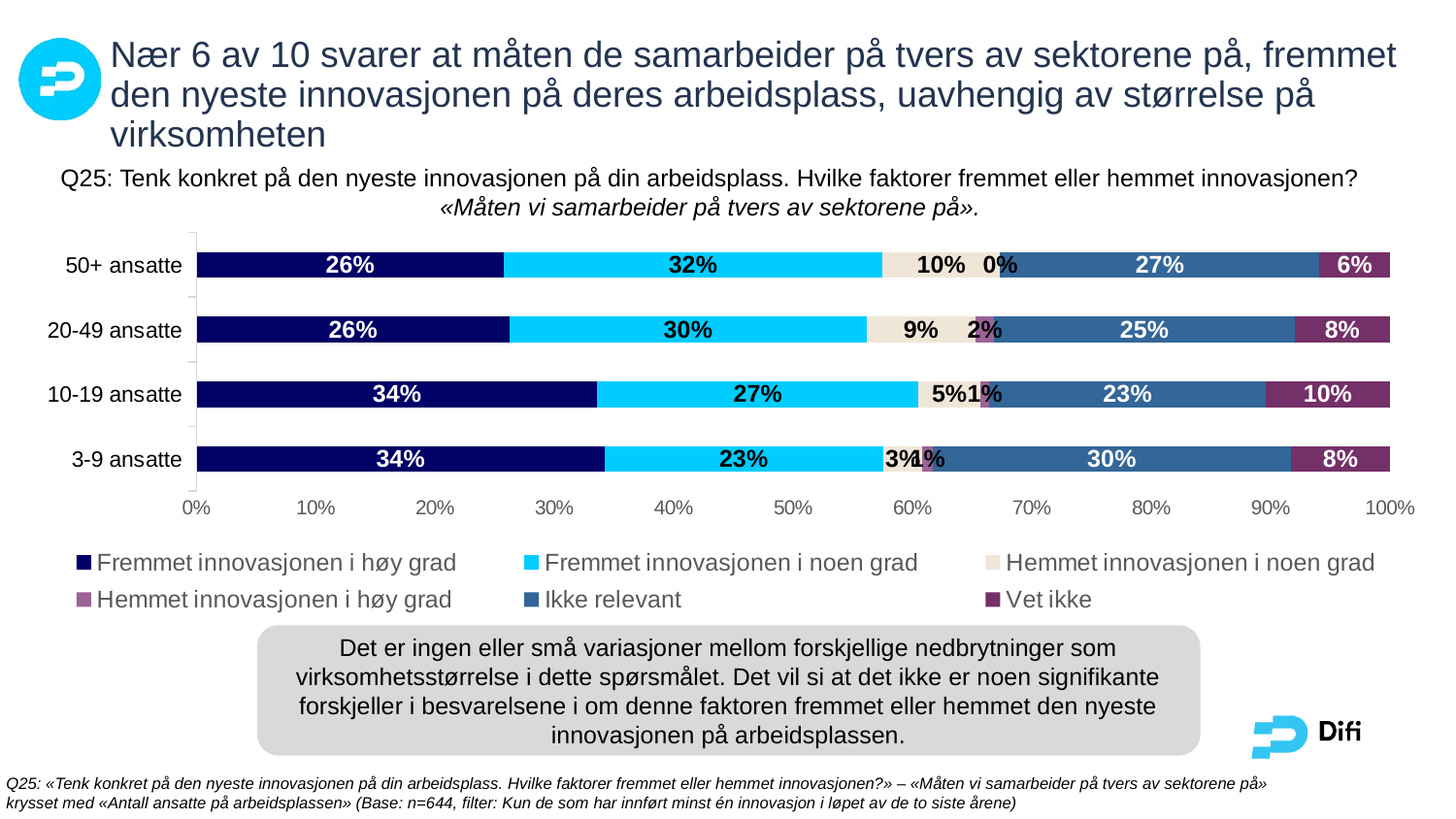
What is the value of "Fremmet innovasjonen i noen grad" for 50+ ansatte? 32% Which category has the highest value for "Fremmet innovasjonen i noen grad"? 50+ ansatte What kind of chart is shown on the slide? Stacked bar chart What is the difference between the "Fremmet innovasjonen i noen grad" values for 50+ ansatte and 3-9 ansatte? 9% What is the value of "Fremmet innovasjonen i høy grad" for 10-19 ansatte? 34% Which legend entry is shown in the light cyan colour? Fremmet innovasjonen i noen grad What is the value of "Ikke relevant" for 20-49 ansatte? 25% How many series does the legend list? 6 What is the value of "Vet ikke" for 10-19 ansatte? 10% Which category has the lowest value for "Ikke relevant"? 10-19 ansatte Which is larger: "Hemmet innovasjonen i noen grad" for 50+ ansatte or for 20-49 ansatte? 50+ ansatte How many categories (company size groups) are shown on the y axis? 4